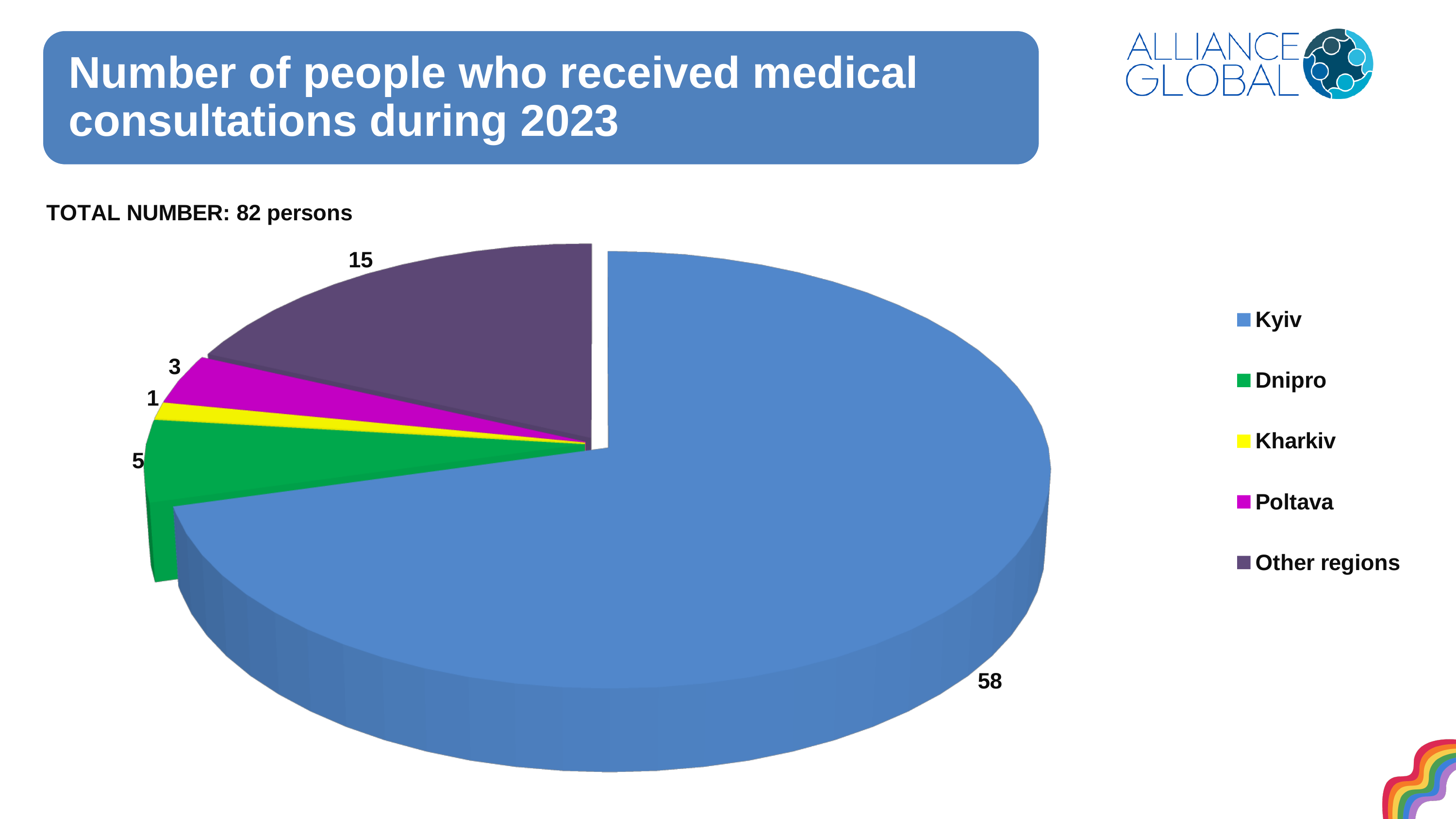
How many slices does the pie chart have? 5 What kind of chart is shown on the slide? Pie chart What colour is the slice for Kharkiv? Yellow What is the value for Other regions? 15 What is the value for Poltava? 3 How many people received medical consultations in Kyiv? 58 Which region has the smallest slice of the pie? Kharkiv Which region has the largest slice of the pie? Kyiv What is the value for Dnipro? 5 What is the difference between the values for Kyiv and Other regions? 43 What is the total of all the slice values in the pie chart? 82 Which is larger, the value for Dnipro or the value for Poltava? Dnipro